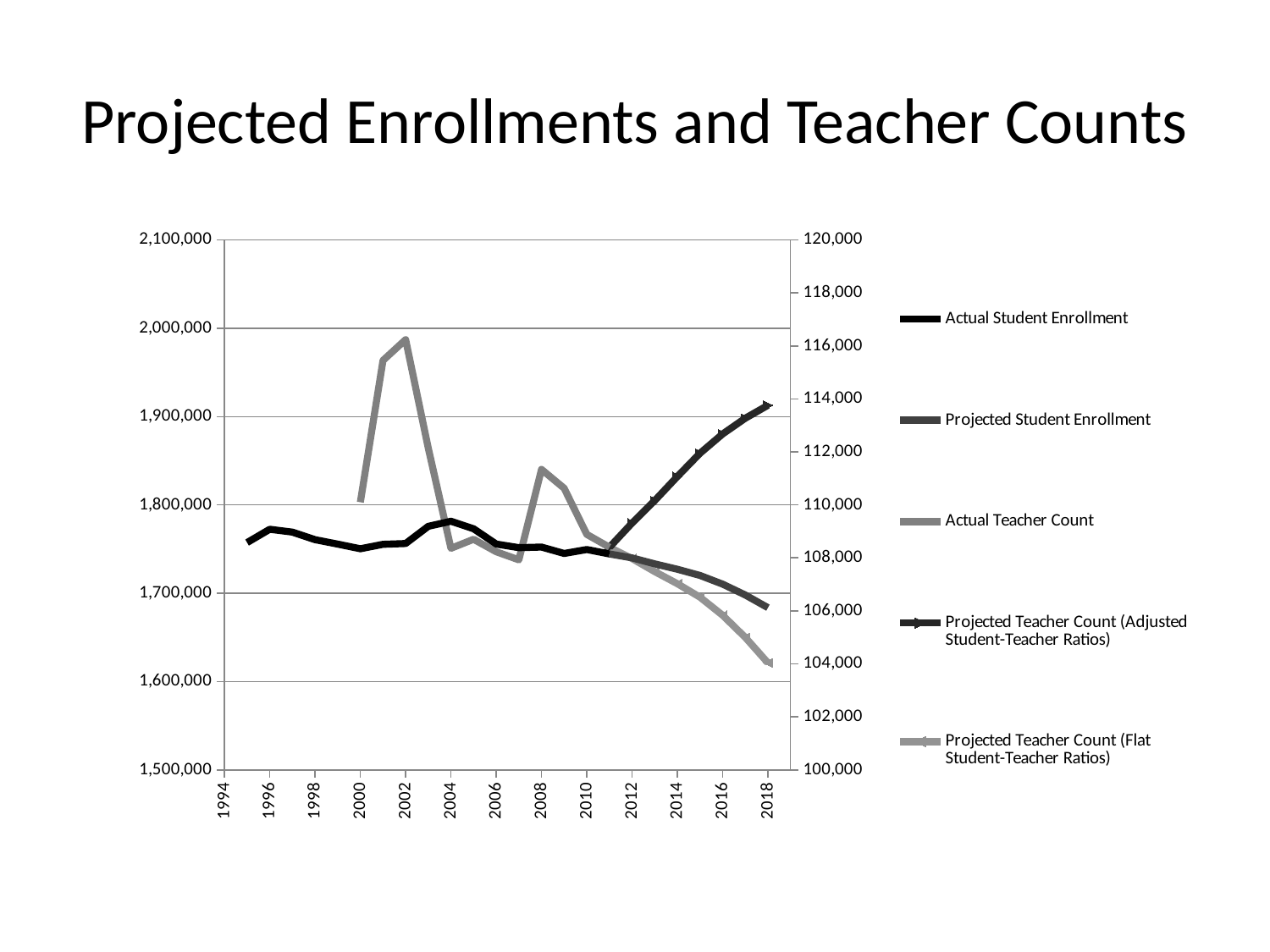
In 2018, which is larger: Projected Teacher Count (Adjusted Student-Teacher Ratios) or Projected Teacher Count (Flat Student-Teacher Ratios)? Projected Teacher Count (Adjusted Student-Teacher Ratios) In which year does the Actual Teacher Count line reach its highest value? 2002 What is the title of the chart? Projected Enrollments and Teacher Counts Is the Actual Student Enrollment value for 2004 greater or less than 1,800,000? less Does the Projected Teacher Count (Adjusted Student-Teacher Ratios) line rise or fall from 2011 to 2018? rise Does the Projected Teacher Count (Flat Student-Teacher Ratios) line rise or fall from 2011 to 2018? fall Does the Projected Student Enrollment line rise or fall from 2011 to 2018? fall What kind of chart is shown on the slide? line chart Is the Projected Teacher Count (Adjusted Student-Teacher Ratios) value for 2018 greater or less than 112,000? greater How many series does the legend list? 5 Is the Actual Teacher Count value for 2002 greater or less than 114,000? greater